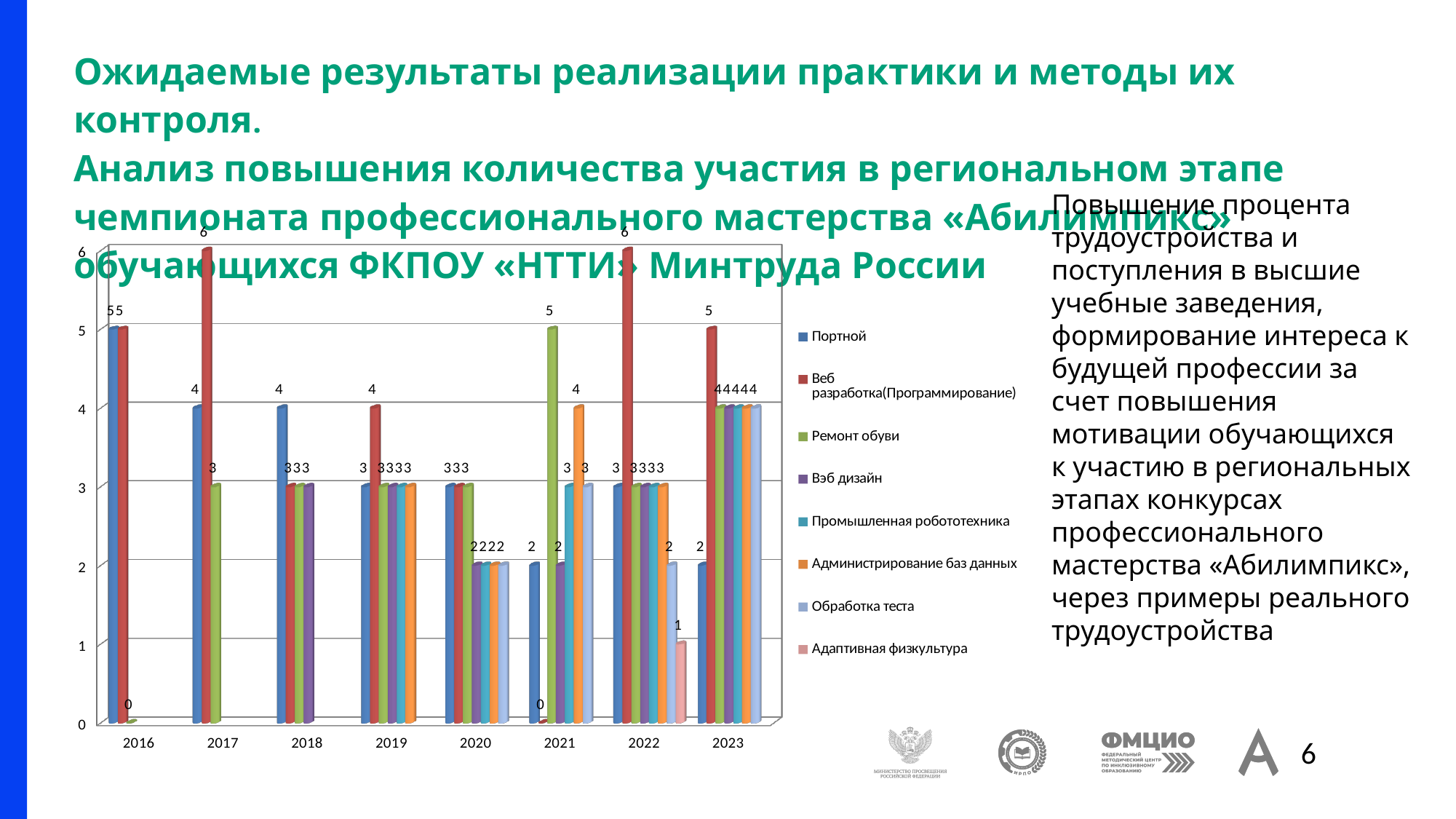
What is the value for Адаптивная физкультура in 2022? 1 How many series does the chart legend list? 8 Which series has the lowest value in 2021? Веб разработка(Программирование) What is the difference between the values for Веб разработка(Программирование) and Портной in 2017? 2 How many years are shown on the x axis of the chart? 8 Does the value for Портной rise or fall from 2016 to 2023? fall What kind of chart is shown on the slide? bar chart What is the value for Портной in 2016? 5 Which is larger in 2021: the value for Администрирование баз данных or the value for Портной? Администрирование баз данных What is the value for Веб разработка(Программирование) in 2017? 6 Which series has the highest value in 2022? Веб разработка(Программирование) What is the value for Ремонт обуви in 2021? 5